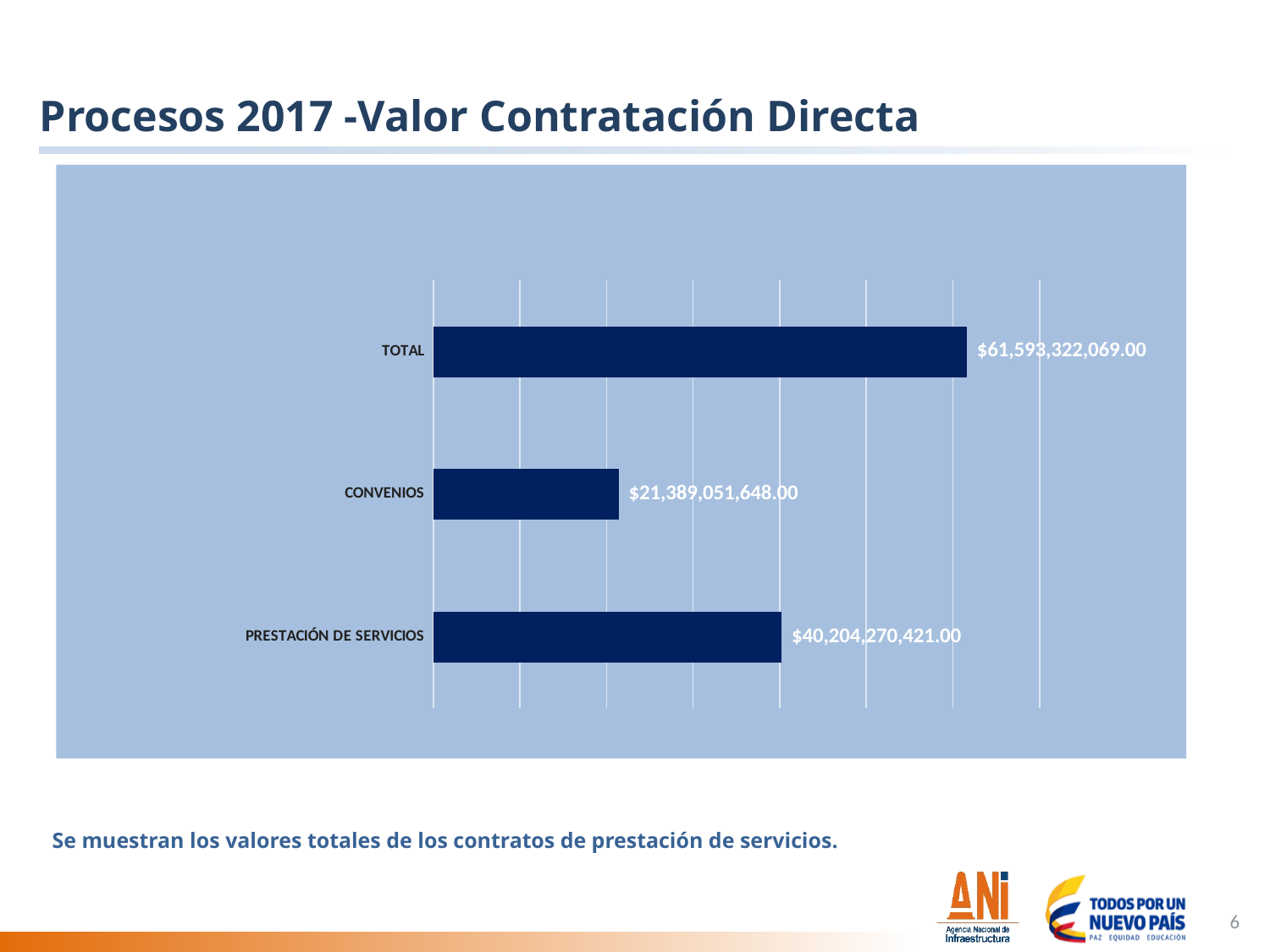
What is the value shown for TOTAL? $61,593,322,069.00 What is the title of the slide containing the chart? Procesos 2017 -Valor Contratación Directa What is the value shown for PRESTACIÓN DE SERVICIOS? $40,204,270,421.00 What is the value shown for CONVENIOS? $21,389,051,648.00 What is the difference between the value for TOTAL and the value for PRESTACIÓN DE SERVICIOS? $21,389,051,648.00 What is the difference between the value for PRESTACIÓN DE SERVICIOS and the value for CONVENIOS? $18,815,218,773.00 What colour are the bars in the chart? Dark blue Which category has the lowest value? CONVENIOS What kind of chart is shown on the slide? Bar chart How many categories are shown in the chart? 3 Which category has the highest value? TOTAL Which is larger, the value for CONVENIOS or the value for PRESTACIÓN DE SERVICIOS? PRESTACIÓN DE SERVICIOS